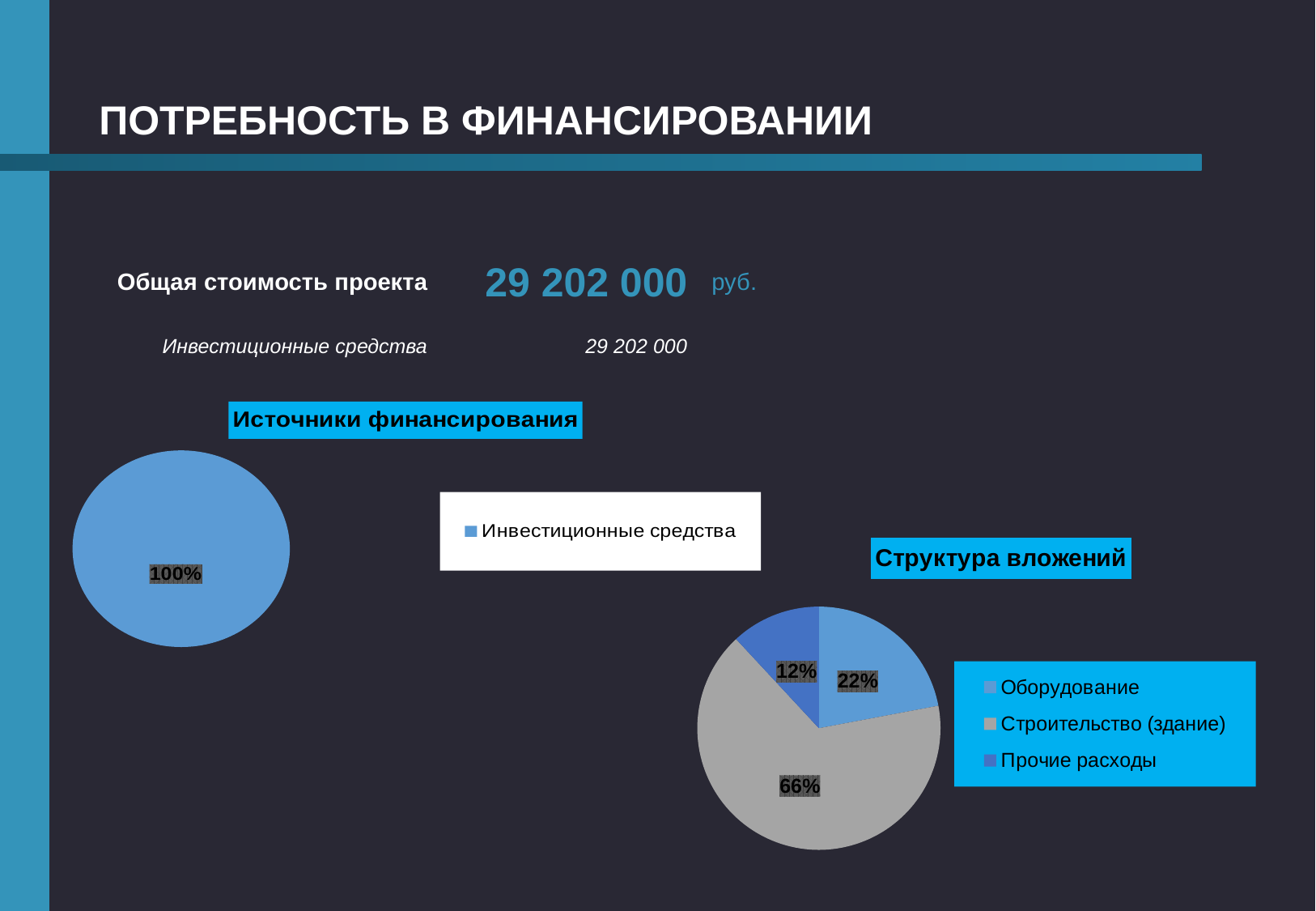
In the 'Структура вложений' chart, which is larger: 'Оборудование' or 'Прочие расходы'? Оборудование What is the title of the chart on the right side of the slide? Структура вложений How many slices does the 'Структура вложений' chart have? 3 How many entries does the legend of the 'Структура вложений' chart list? 3 In the 'Структура вложений' chart, what is the difference in percentage points between 'Строительство (здание)' and 'Оборудование'? 44 In the 'Структура вложений' chart, what share does 'Прочие расходы' have? 12% In the 'Структура вложений' chart, what share does 'Оборудование' have? 22% What kind of chart is the 'Источники финансирования' chart? Pie chart In the 'Структура вложений' chart, what share does 'Строительство (здание)' have? 66% In the 'Источники финансирования' chart, what share does 'Инвестиционные средства' have? 100% In the 'Структура вложений' chart, which category has the smallest share? Прочие расходы In the 'Структура вложений' chart, which category has the largest share? Строительство (здание)